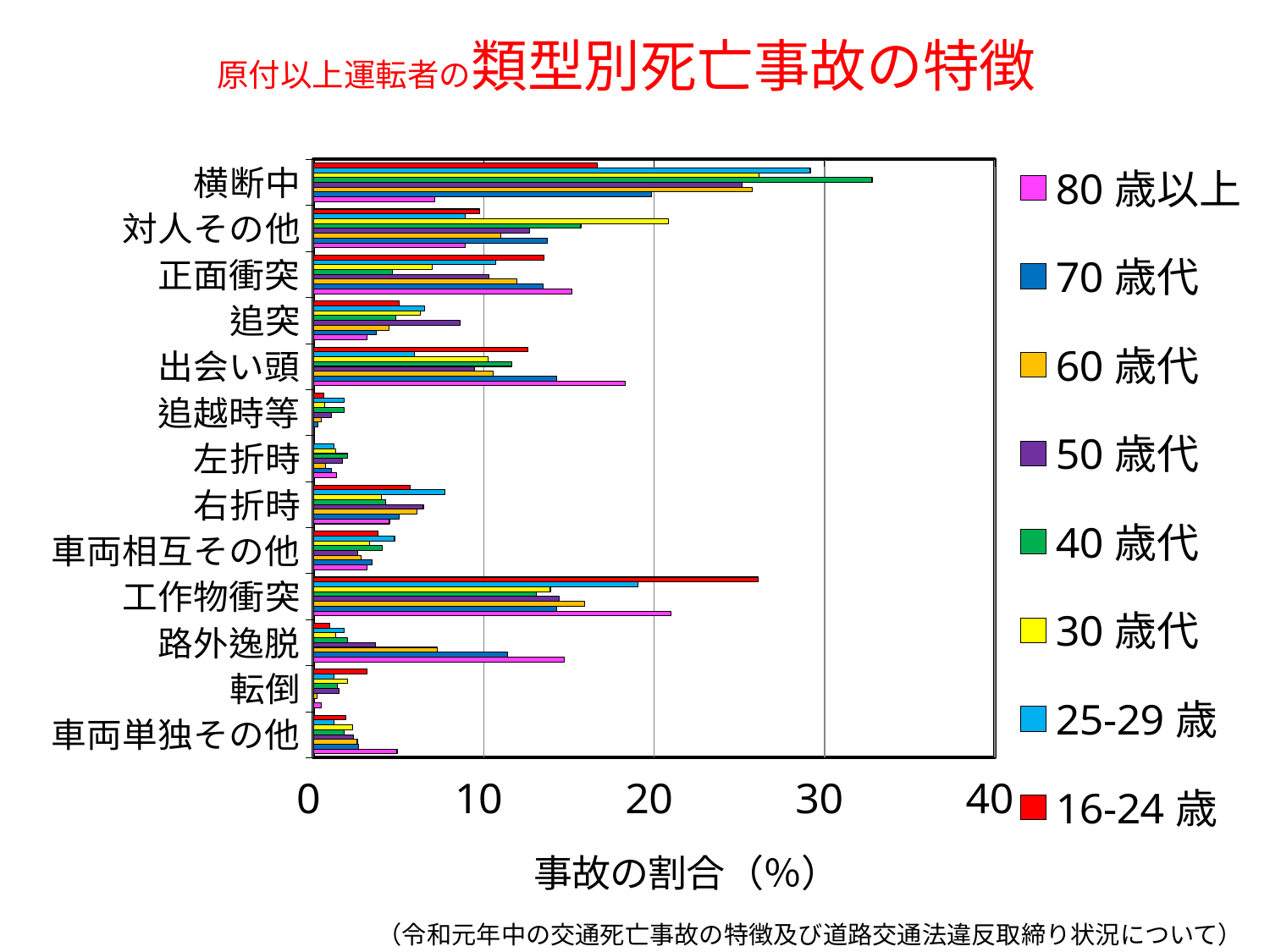
What kind of chart is shown on the slide? bar chart Is the value for 40歳代 in the 横断中 category greater or less than 30? greater Is the value for 80歳以上 in the 横断中 category greater or less than 10? less How many series does the legend list? 8 Is the value for 16-24歳 in the 工作物衝突 category greater or less than 20? greater In the 工作物衝突 category, which is larger: the value for 16-24歳 or for 80歳以上? 16-24歳 Within the 横断中 category, which age group has the lowest value? 80歳以上 How many accident-type categories are shown on the y axis? 13 Within the 横断中 category, which age group has the highest value? 40歳代 In the 出会い頭 category, which is larger: the value for 80歳以上 or for 25-29歳? 80歳以上 What is the title of the x axis? 事故の割合（%）